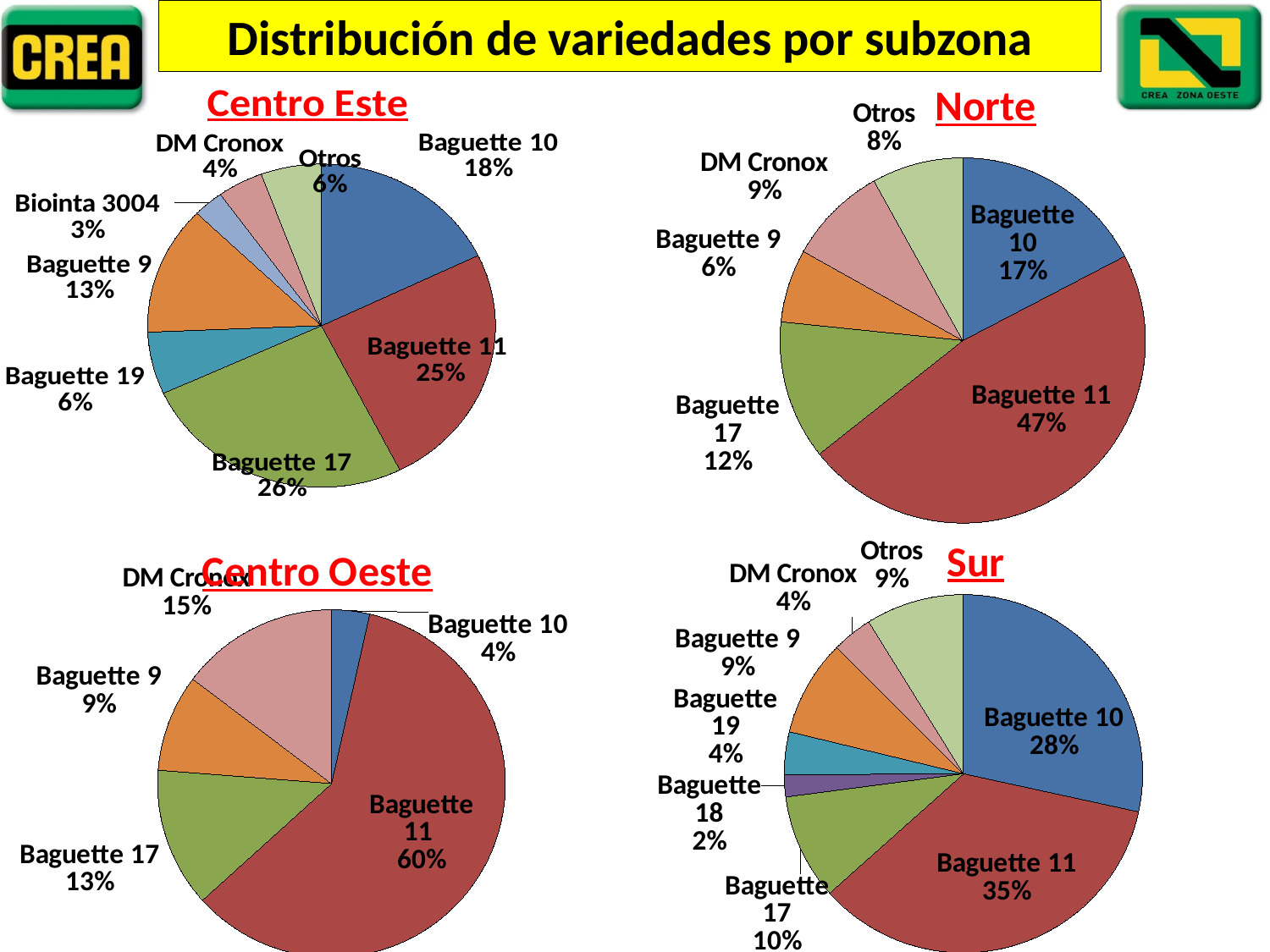
In the Centro Oeste chart, which variety has the largest share? Baguette 11 In the Sur chart, what is the difference between the shares of Baguette 11 and Baguette 10? 7% How many slices does the Centro Oeste chart have? 5 In the Norte chart, what share does Baguette 11 have? 47% In the Centro Este chart, what share does Baguette 17 have? 26% How many slices does the Sur chart have? 8 In the Centro Oeste chart, what share does DM Cronox have? 15% In the Centro Este chart, which variety has the smallest share? Biointa 3004 What is the title of the slide? Distribución de variedades por subzona In the Sur chart, what share does Baguette 18 have? 2% What kind of chart is the Norte chart? Pie chart In the Norte chart, which is larger, the share of DM Cronox or the share of Baguette 9? DM Cronox